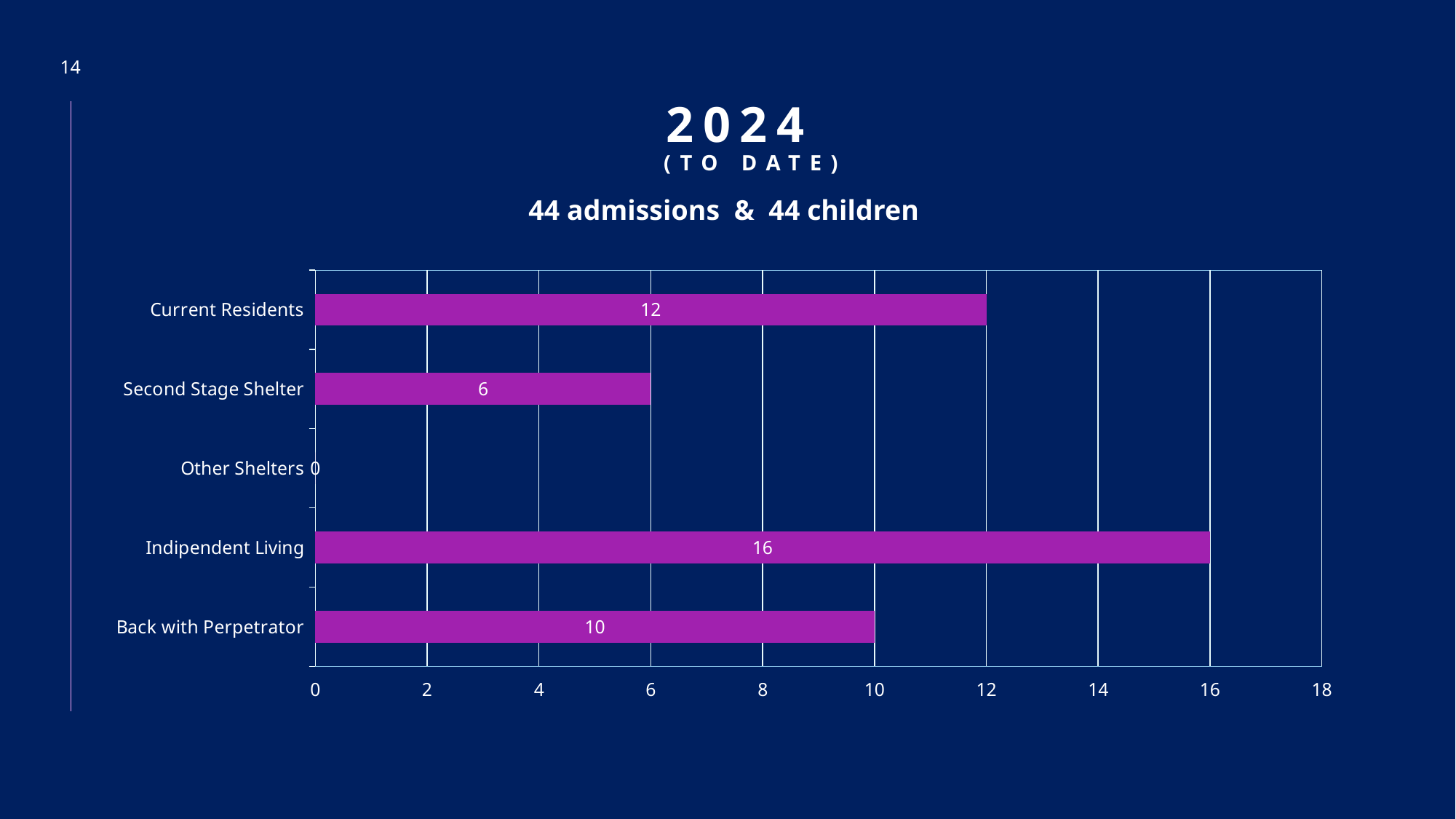
Which is larger, the value for Back with Perpetrator or the value for Second Stage Shelter? Back with Perpetrator How many categories are shown in the chart? 5 What kind of chart is shown on the slide? Bar chart What is the highest value shown on the x axis? 18 Which category has the lowest value? Other Shelters What is the value for Other Shelters? 0 What is the value for Back with Perpetrator? 10 What is the value for Second Stage Shelter? 6 Which category has the highest value? Indipendent Living What is the value for Indipendent Living? 16 What is the difference between the values for Indipendent Living and Current Residents? 4 What is the value for Current Residents? 12